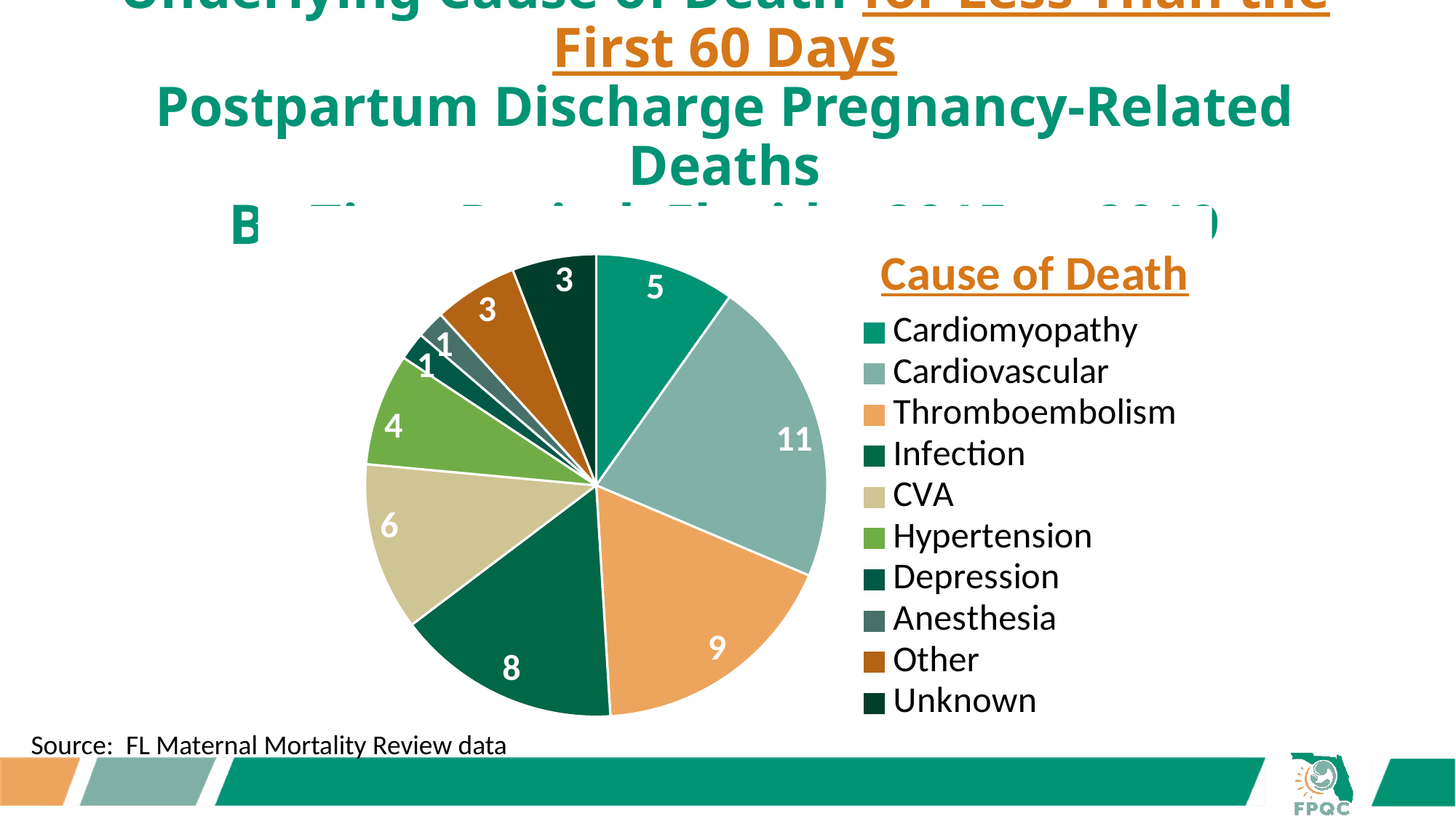
How many deaths are attributed to Cardiovascular causes in the pie chart? 11 What is the value for Hypertension in the pie chart? 4 What kind of chart is shown on the slide? pie chart What is the value for CVA in the pie chart? 6 What is the value for Thromboembolism in the pie chart? 9 What is the title of the legend next to the pie chart? Cause of Death What is the total of all the slice values in the pie chart? 51 Which is larger in the pie chart, Thromboembolism or Hypertension? Thromboembolism What is the difference between the Cardiovascular and Cardiomyopathy values in the pie chart? 6 What is the value for Infection in the pie chart? 8 How many categories does the legend of the pie chart list? 10 Which cause of death has the largest slice in the pie chart? Cardiovascular